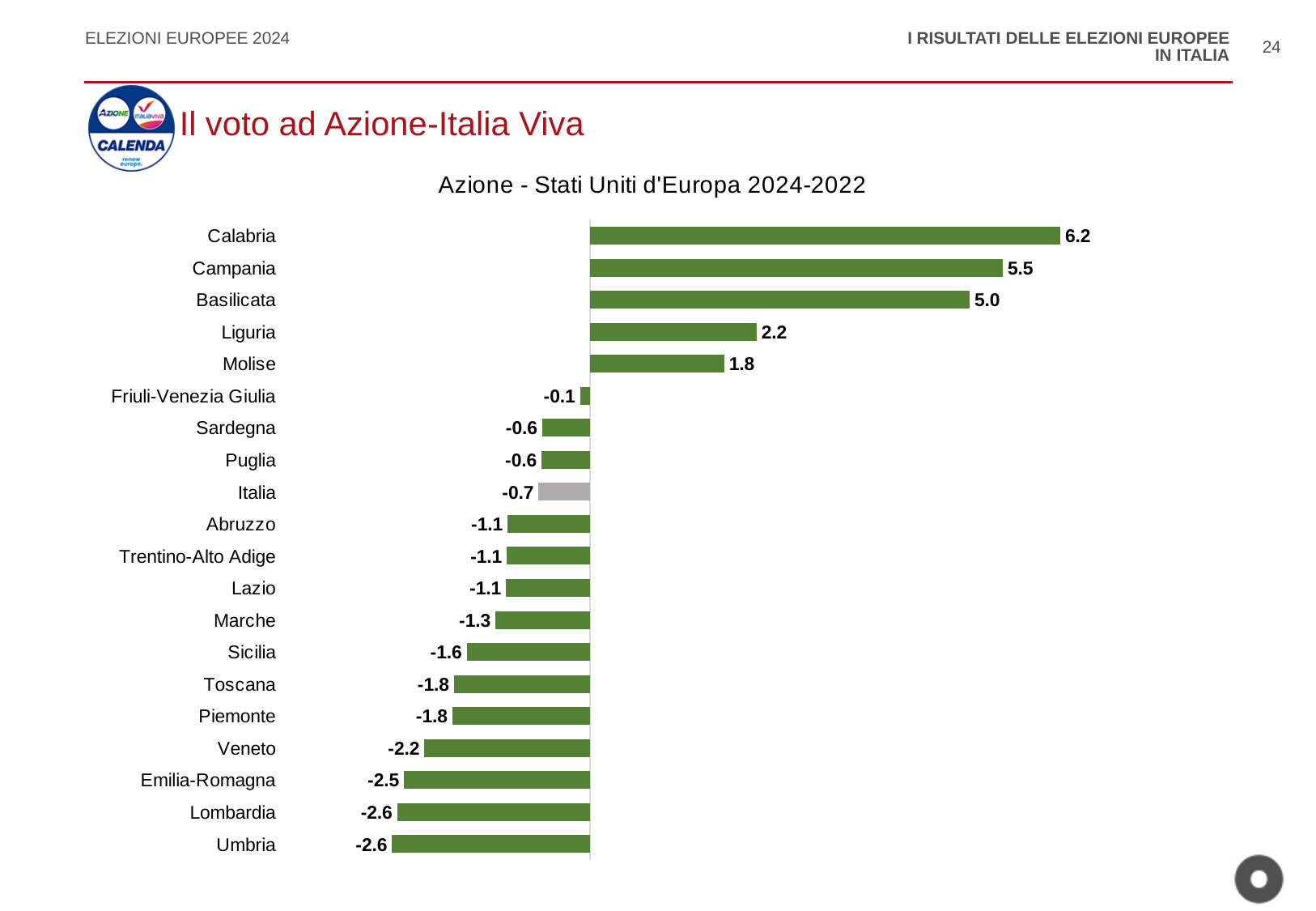
Which has the larger value, Liguria or Molise? Liguria What is the difference between the values for Calabria and Campania? 0.7 What is the value for Molise? 1.8 What is the value for Lombardia? -2.6 What is the title of the chart? Azione - Stati Uniti d'Europa 2024-2022 Which has the larger value, Sicilia or Veneto? Sicilia What kind of chart is shown on the slide? Bar chart How many categories are shown in the chart? 20 Which region has the highest value? Calabria What is the difference between the values for Basilicata and Liguria? 2.8 What is the value for Italia? -0.7 What is the value for Calabria? 6.2